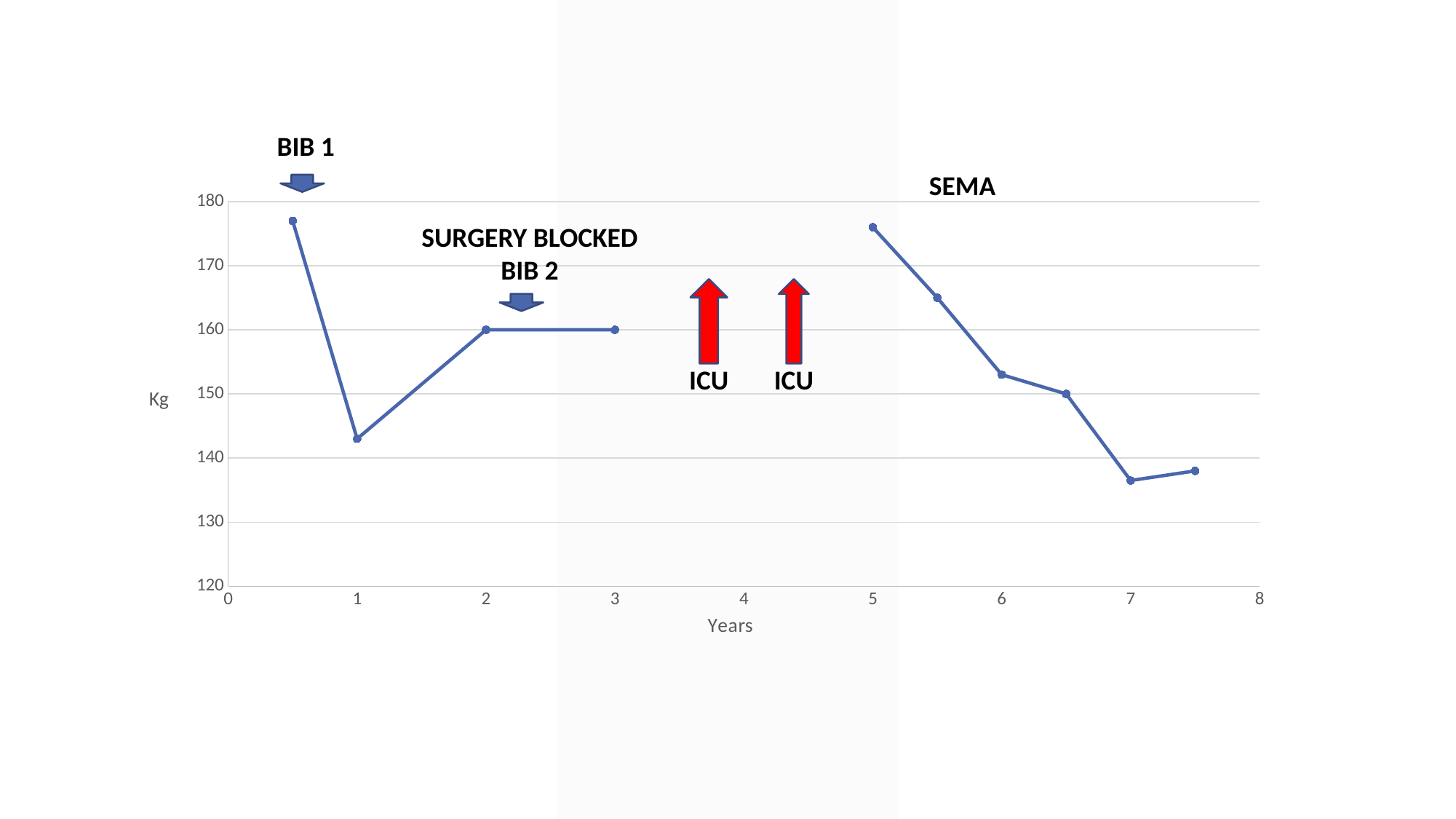
Is the value at year 1 greater or less than 150? less What is the label on the vertical axis? Kg Do the values rise or fall from year 5 to year 7? fall What is the value in Kg at year 2? 160 What is the value in Kg at year 3? 160 Is the value at year 6 greater or less than 150? greater Is the value at year 0.5 greater or less than 170? greater What kind of chart is shown on the slide? line chart How many data points are plotted on the line? 10 Which is larger, the value at year 1 or the value at year 2? year 2 Which is larger, the value at year 5 or the value at year 6? year 5